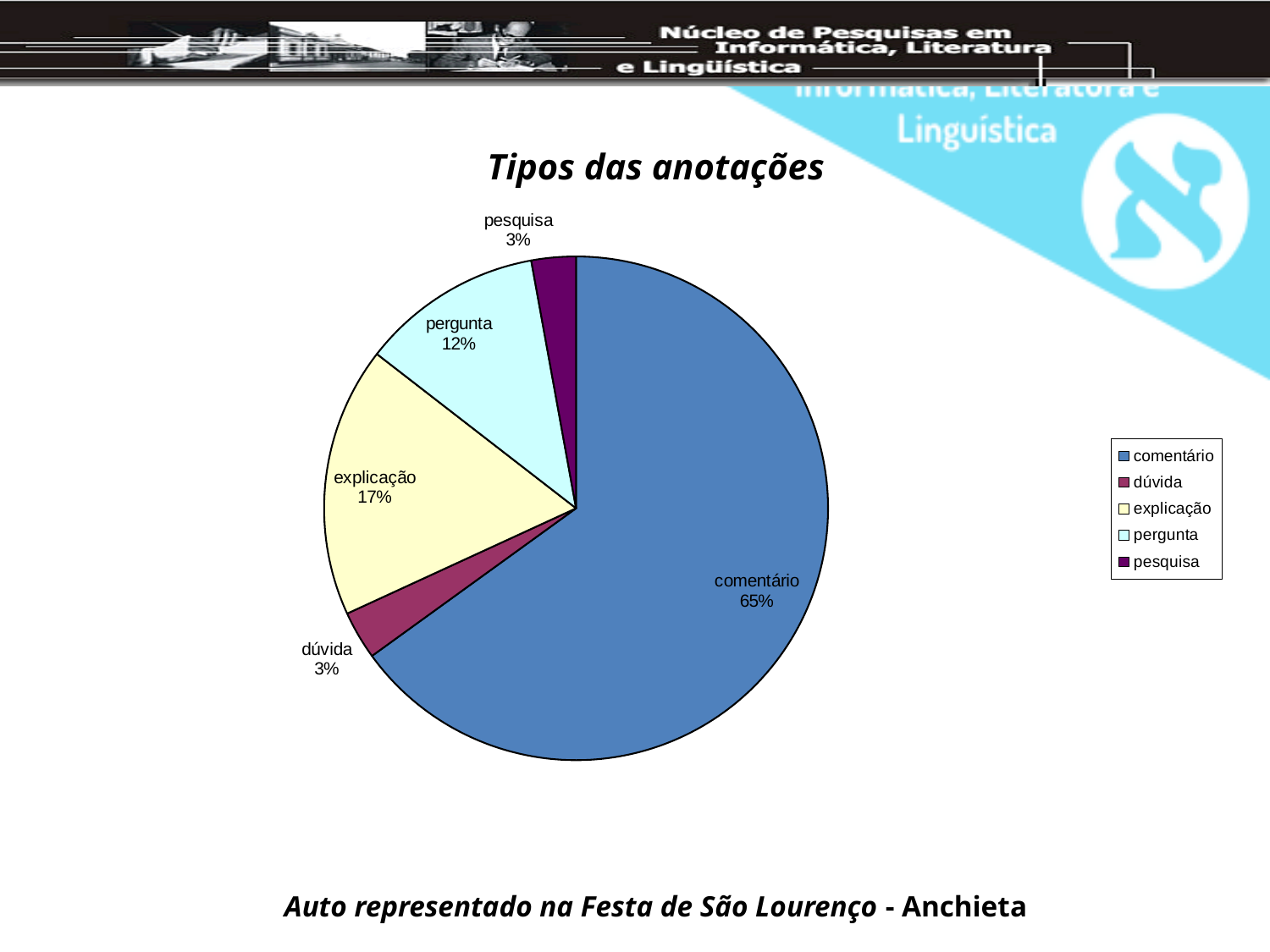
What is the difference in percentage points between comentário and explicação? 48 How many categories are shown in the pie chart? 5 What type of chart is shown on the slide? pie chart Which category has the largest share of the pie? comentário How many entries does the legend list? 5 What percentage of the pie does pesquisa represent? 3% What percentage of the pie does explicação represent? 17% What percentage of the pie does pergunta represent? 12% Which is larger, the share for pergunta or the share for dúvida? pergunta What is the title of the chart? Tipos das anotações What is the difference in percentage points between explicação and pergunta? 5 What percentage of the pie does comentário represent? 65%